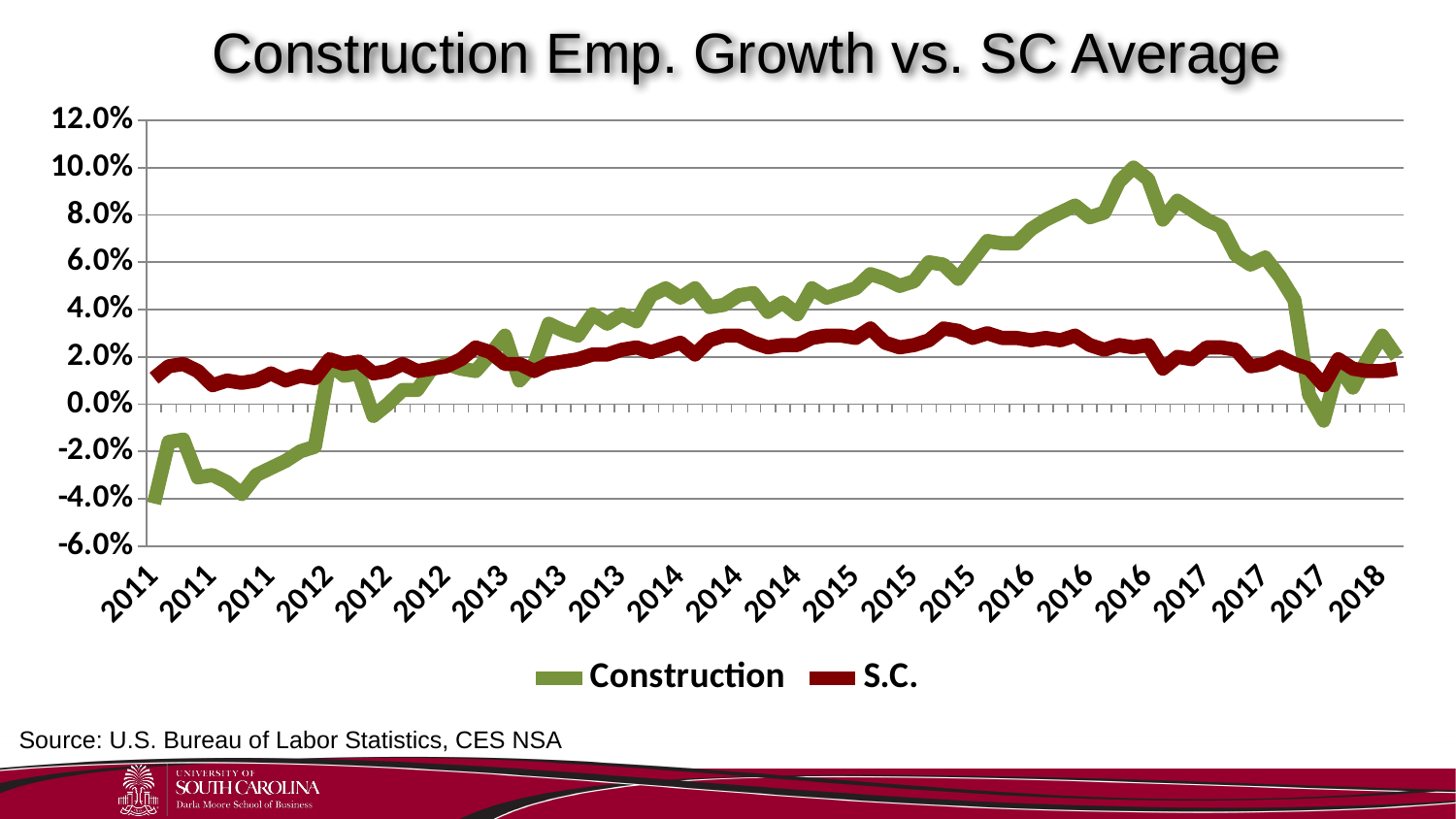
What is the title of the chart? Construction Emp. Growth vs. SC Average Is the highest value of the S.C. line greater or less than 4.0%? less Is the highest value of the Construction line greater or less than 8.0%? greater Which series is drawn in dark red? S.C. What kind of chart is shown on the slide? line chart How many series does the legend list? 2 Is the lowest value of the Construction line greater or less than -2.0%? less At the first point in 2011, which series is higher, Construction or S.C.? S.C. Does the Construction line rise or fall from its 2016 peak through 2017? fall Does the Construction line generally rise or fall from 2011 to 2016? rise In 2016, which series is higher, Construction or S.C.? Construction